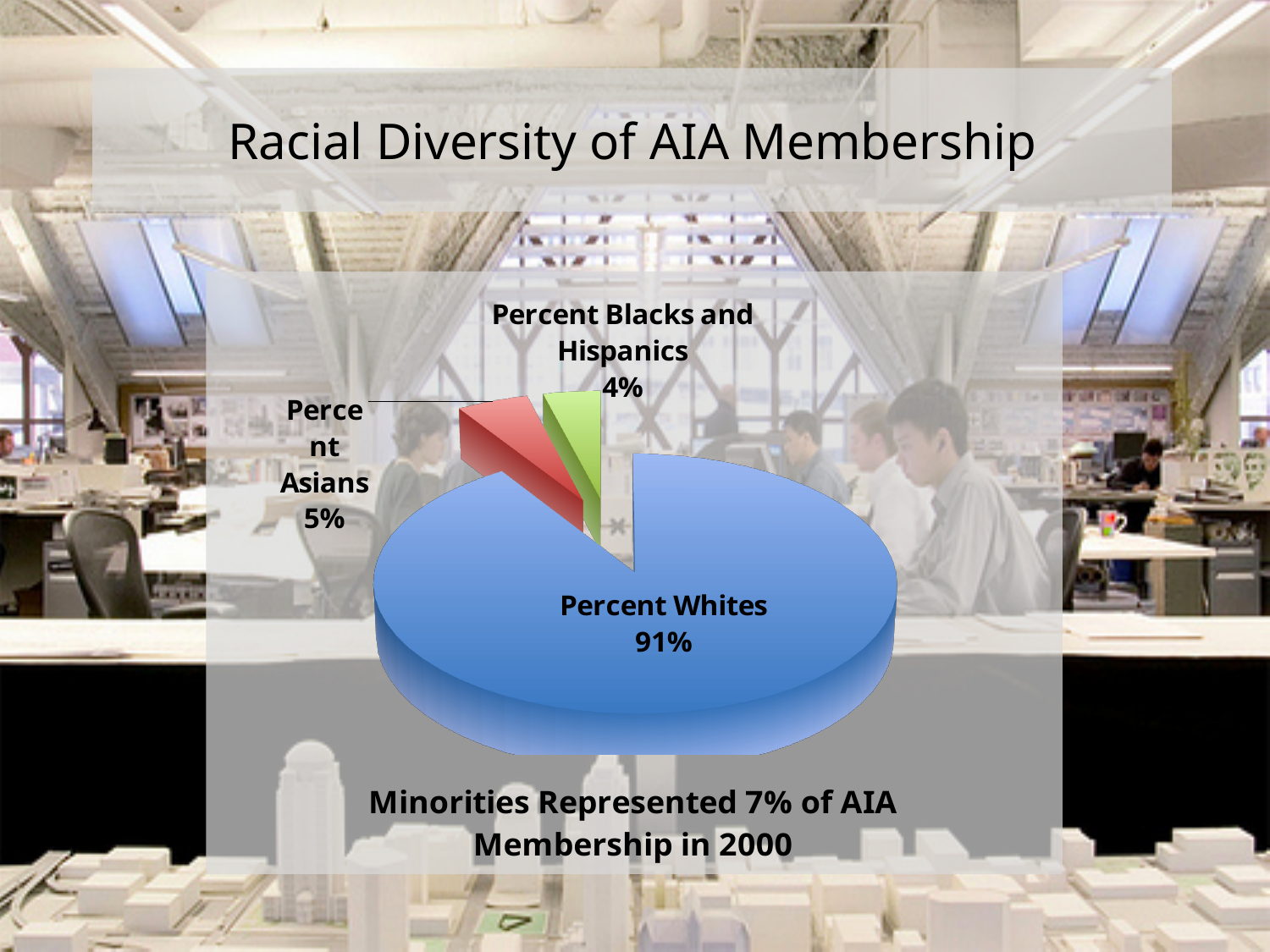
What percentage of AIA membership is labelled as Percent Whites? 91% What is the difference between the Percent Whites slice and the Percent Asians slice? 86% How many slices does the pie chart have? 3 Which slice of the pie chart is the smallest? Percent Blacks and Hispanics Which is larger, the Percent Asians slice or the Percent Blacks and Hispanics slice? Percent Asians What is the combined share of the Percent Asians and Percent Blacks and Hispanics slices? 9% Which slice of the pie chart is the largest? Percent Whites What percentage is shown for Percent Asians? 5% What colour is the Percent Whites slice of the pie chart? Blue What is the title of the slide containing the pie chart? Racial Diversity of AIA Membership What percentage is shown for Percent Blacks and Hispanics? 4% What kind of chart is shown on the slide? Pie chart